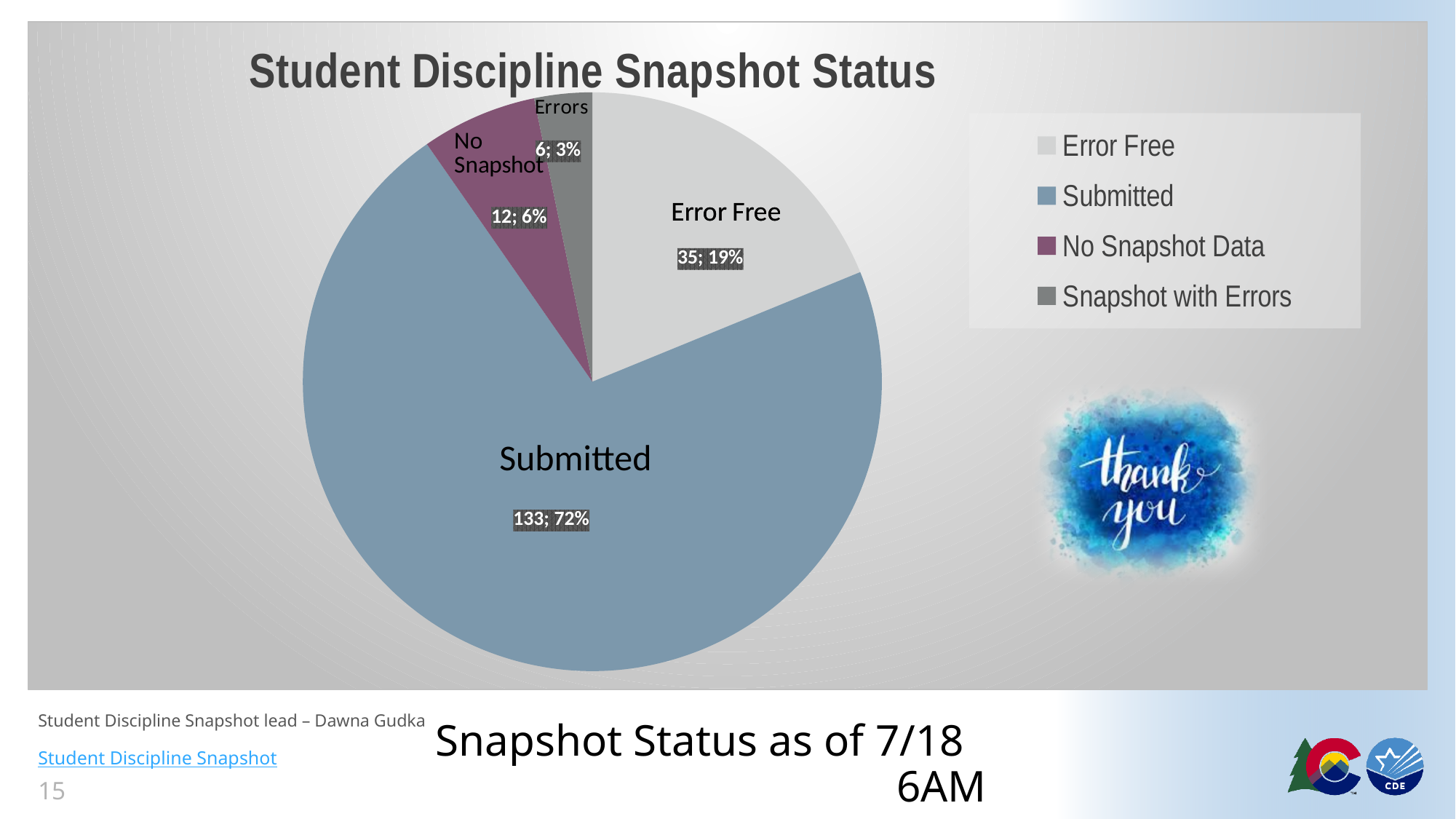
Which category has the smallest slice? Snapshot with Errors How many slices does the pie chart have? 4 Which category has the largest slice? Submitted What is the count shown for the Submitted slice? 133 What percentage share does the Snapshot with Errors slice have? 3% What is the count shown for the No Snapshot Data slice? 12 What kind of chart is shown on the slide? Pie chart What percentage share does the Error Free slice have? 19% What is the title of the chart? Student Discipline Snapshot Status How many entries does the legend list? 4 What is the count shown for the Error Free slice? 35 What percentage share does the Submitted slice have? 72%